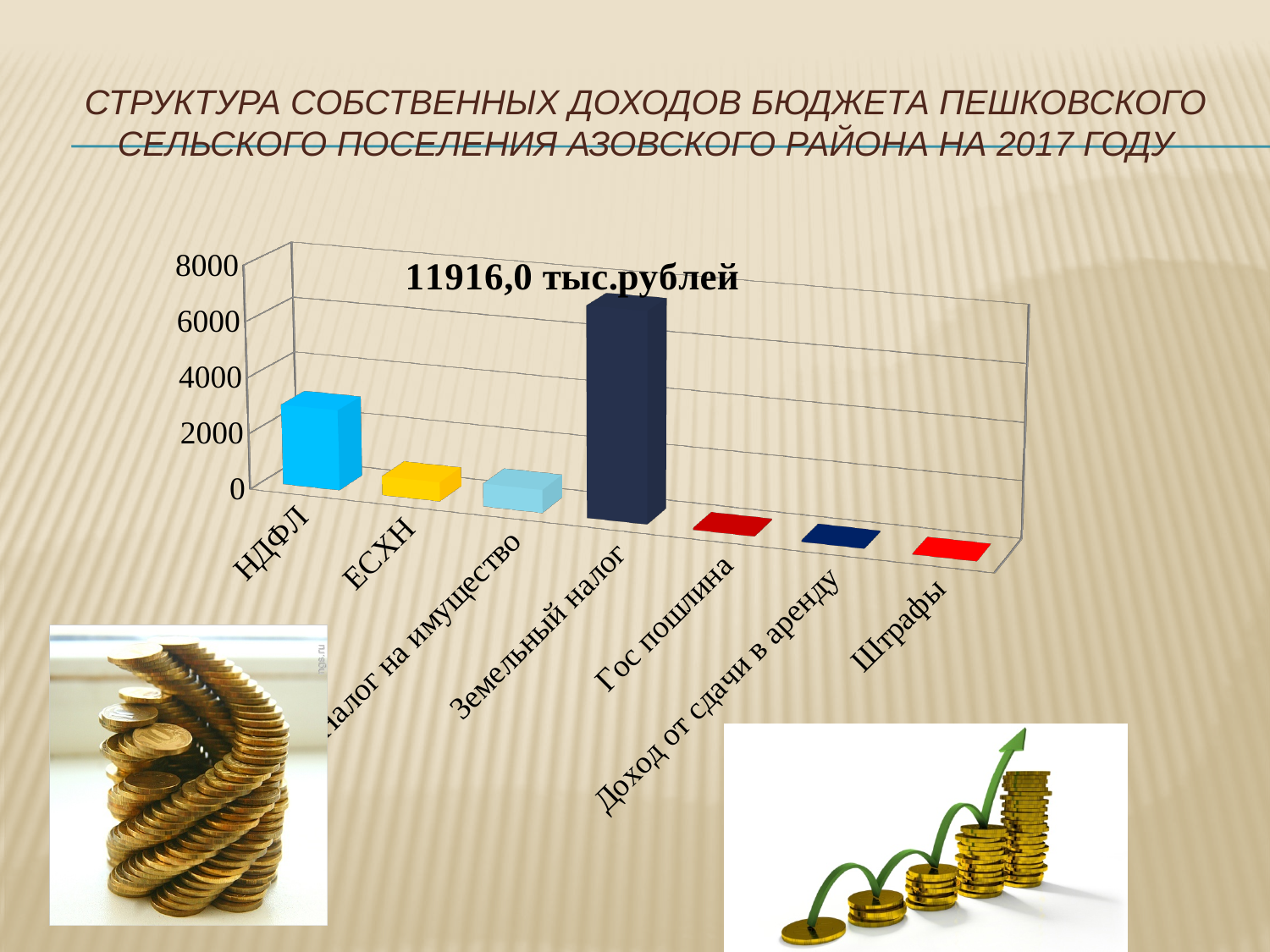
What text label is printed at the top of the chart area? 11916,0 тыс.рублей How many categories are shown on the x axis of the chart? 7 Is the value for Штрафы greater or less than 2000? less Which category has the highest value in the chart? Земельный налог Is the value for НДФЛ greater or less than 2000? greater What is the highest value shown on the chart's vertical axis? 8000 Is the value for ЕСХН greater or less than 2000? less What kind of chart is shown on the slide? bar chart Which is larger, the value for Земельный налог or the value for НДФЛ? Земельный налог Which is larger, the value for НДФЛ or the value for ЕСХН? НДФЛ